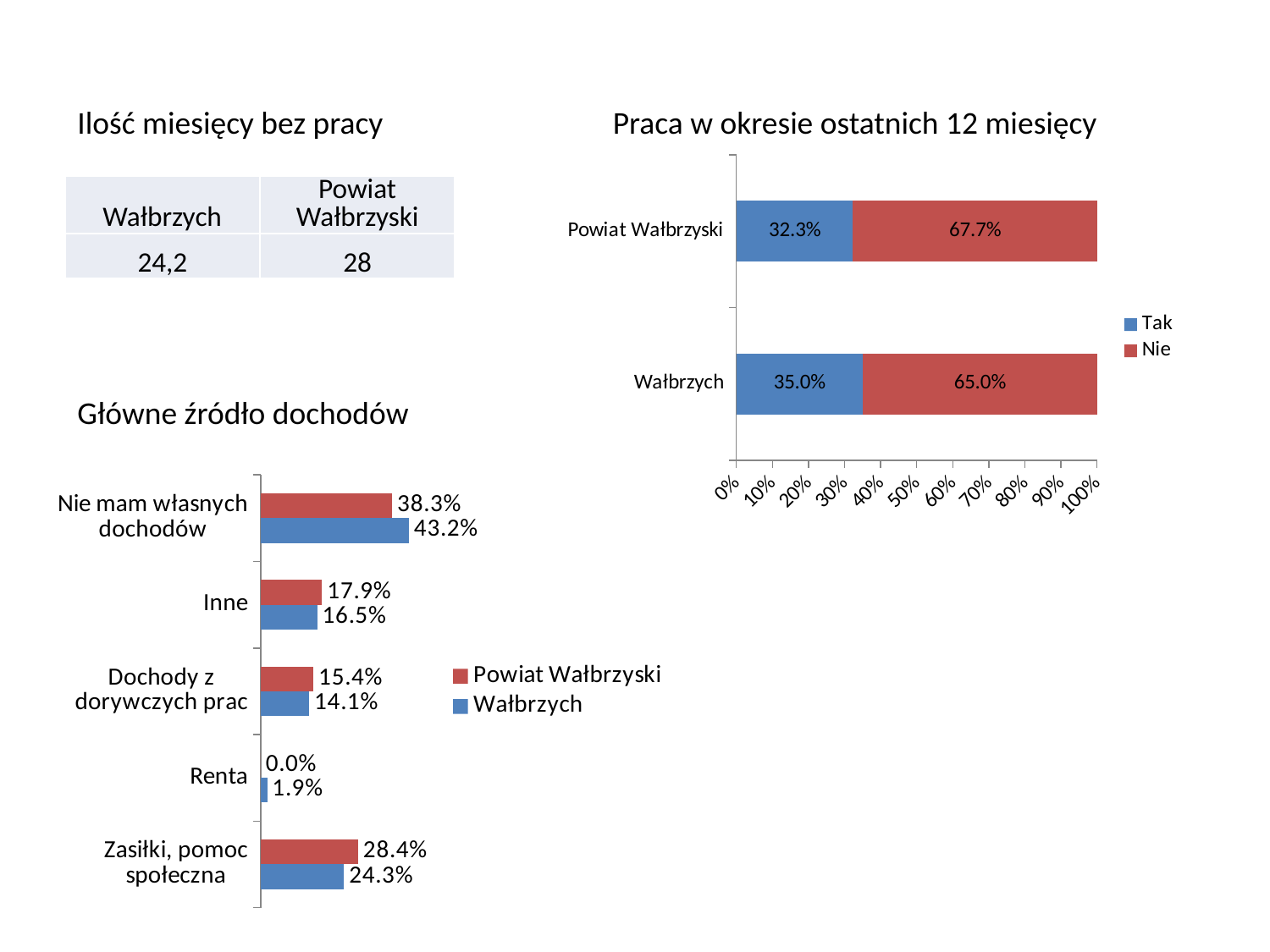
In the 'Praca w okresie ostatnich 12 miesięcy' chart, what is the 'Tak' value for Wałbrzych? 35.0% What kind of chart is 'Główne źródło dochodów'? Bar chart In the 'Główne źródło dochodów' chart, what is the Powiat Wałbrzyski value for 'Zasiłki, pomoc społeczna'? 28.4% In the 'Praca w okresie ostatnich 12 miesięcy' chart, what is the difference between the 'Tak' values for Wałbrzych and Powiat Wałbrzyski? 2.7% In the 'Główne źródło dochodów' chart, which category has the lowest Powiat Wałbrzyski value? Renta In the 'Praca w okresie ostatnich 12 miesięcy' chart, what is the 'Nie' value for Powiat Wałbrzyski? 67.7% In the 'Praca w okresie ostatnich 12 miesięcy' chart, what is the total of the stacked bar for Wałbrzych? 100.0% In the 'Praca w okresie ostatnich 12 miesięcy' chart, how many series does the legend list? 2 In the 'Główne źródło dochodów' chart, what is the Wałbrzych value for 'Nie mam własnych dochodów'? 43.2% In the 'Główne źródło dochodów' chart, what is the difference between the Wałbrzych and Powiat Wałbrzyski values for 'Nie mam własnych dochodów'? 4.9% In the 'Główne źródło dochodów' chart, how many categories are shown? 5 In the 'Główne źródło dochodów' chart, which category has the highest Wałbrzych value? Nie mam własnych dochodów